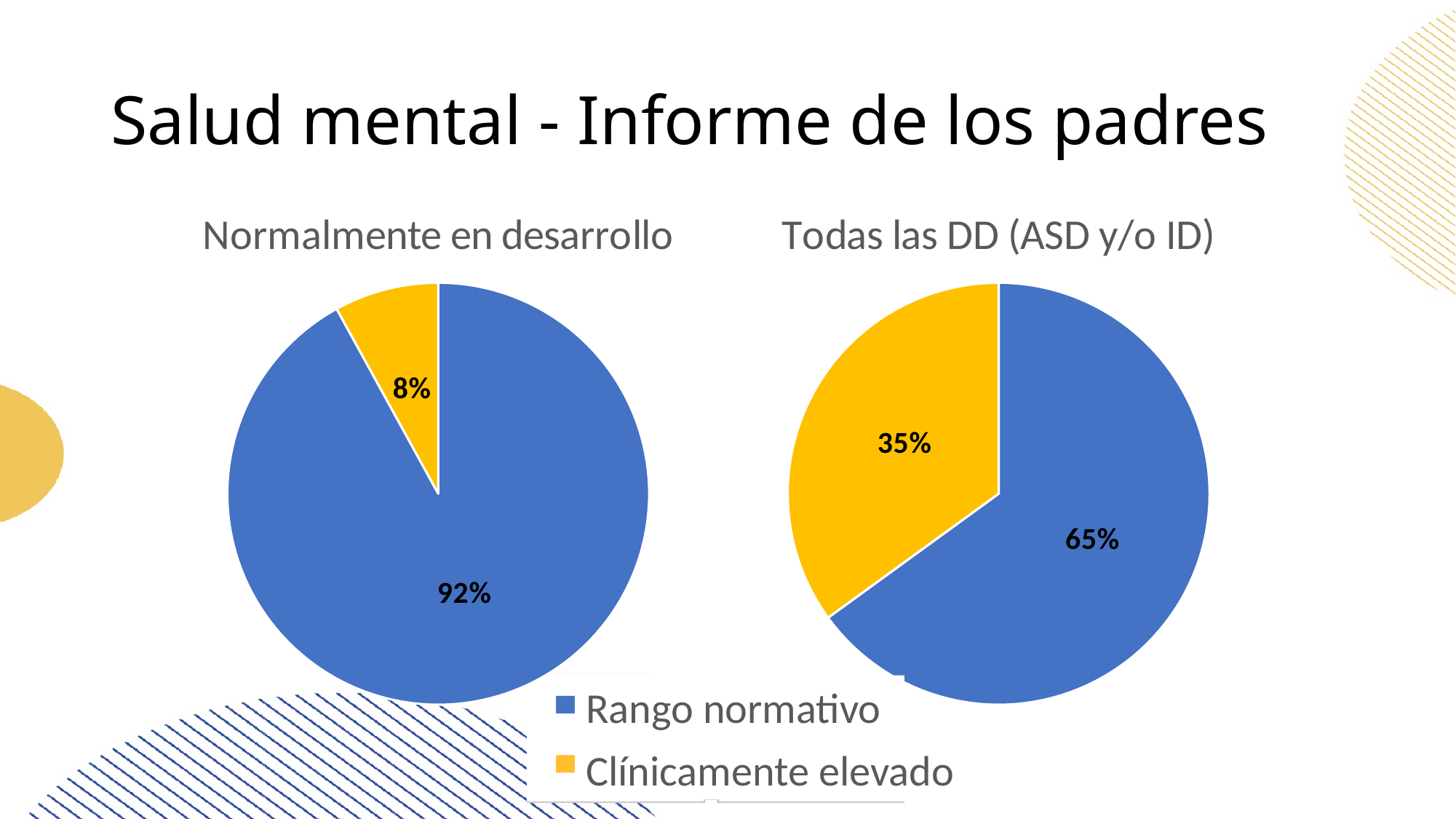
In the 'Todas las DD (ASD y/o ID)' chart, which category has the largest slice? Rango normativo In the 'Normalmente en desarrollo' chart, what percentage is labelled for Rango normativo? 92% In the 'Normalmente en desarrollo' chart, which category has the smallest slice? Clínicamente elevado How many entries does the legend list? 2 What type of chart is used on this slide? Pie chart How many slices does the 'Normalmente en desarrollo' chart have? 2 Which chart has the larger Clínicamente elevado share, 'Normalmente en desarrollo' or 'Todas las DD (ASD y/o ID)'? Todas las DD (ASD y/o ID) In the 'Todas las DD (ASD y/o ID)' chart, what percentage is labelled for Rango normativo? 65% What colour represents Clínicamente elevado in the charts? Yellow In the 'Normalmente en desarrollo' chart, what percentage is labelled for Clínicamente elevado? 8% In the 'Todas las DD (ASD y/o ID)' chart, what percentage is labelled for Clínicamente elevado? 35% In the 'Todas las DD (ASD y/o ID)' chart, what is the difference between the Rango normativo and Clínicamente elevado percentages? 30%